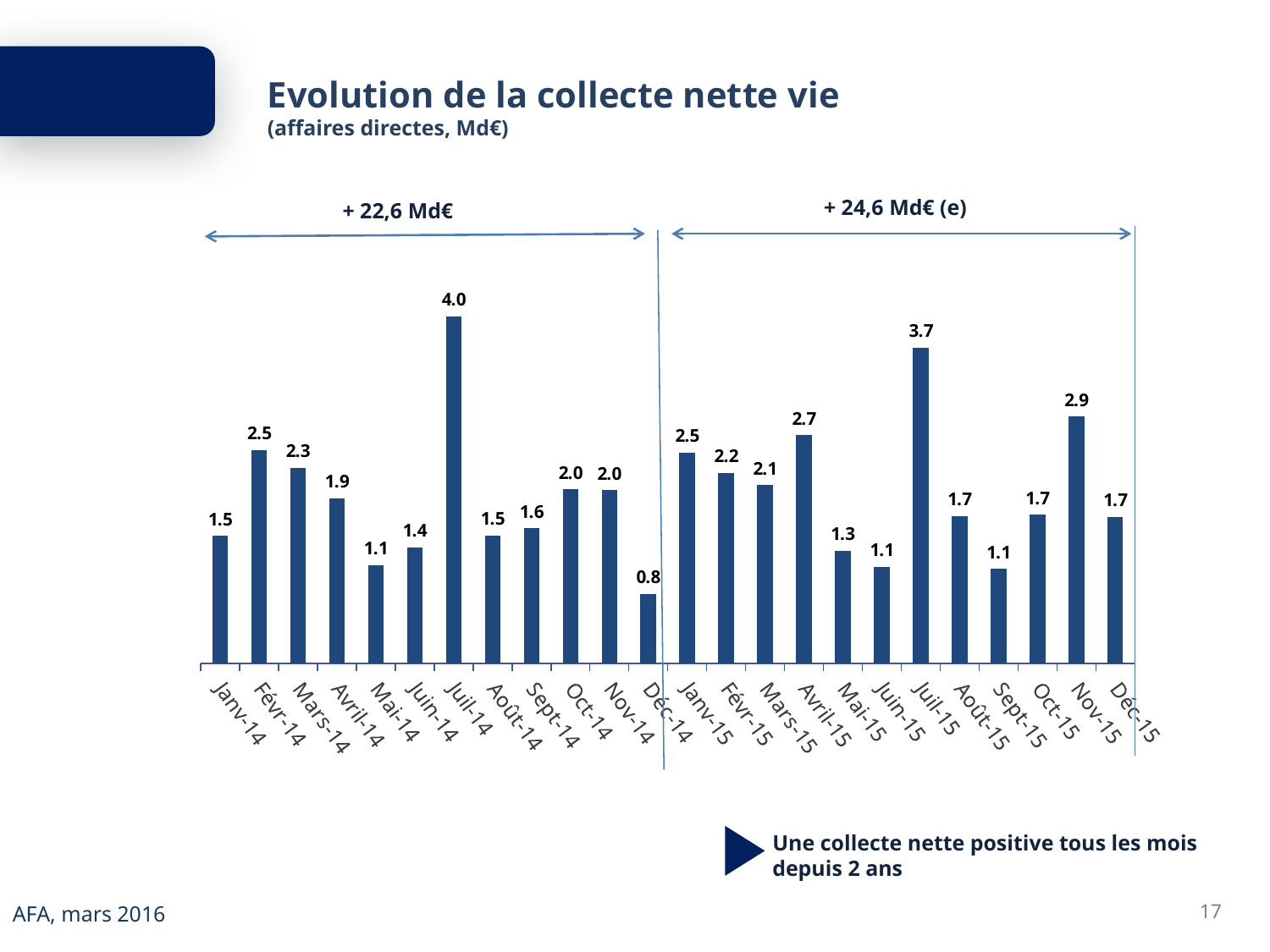
What total is shown above the arrow for 2015? + 24,6 Md€ (e) What is the value for Juil-14? 4.0 What is the difference between the values for Juil-14 and Juil-15? 0.3 What is the difference between the values for Nov-15 and Déc-15? 1.2 Which month has the highest value? Juil-14 What is the value for Déc-15? 1.7 What is the value for Avril-15? 2.7 What kind of chart is shown? Bar chart Which is larger, the value for Févr-14 or the value for Mars-14? Févr-14 Which month has the lowest value? Déc-14 How many months are plotted on the chart? 24 What total is shown above the arrow for 2014? + 22,6 Md€